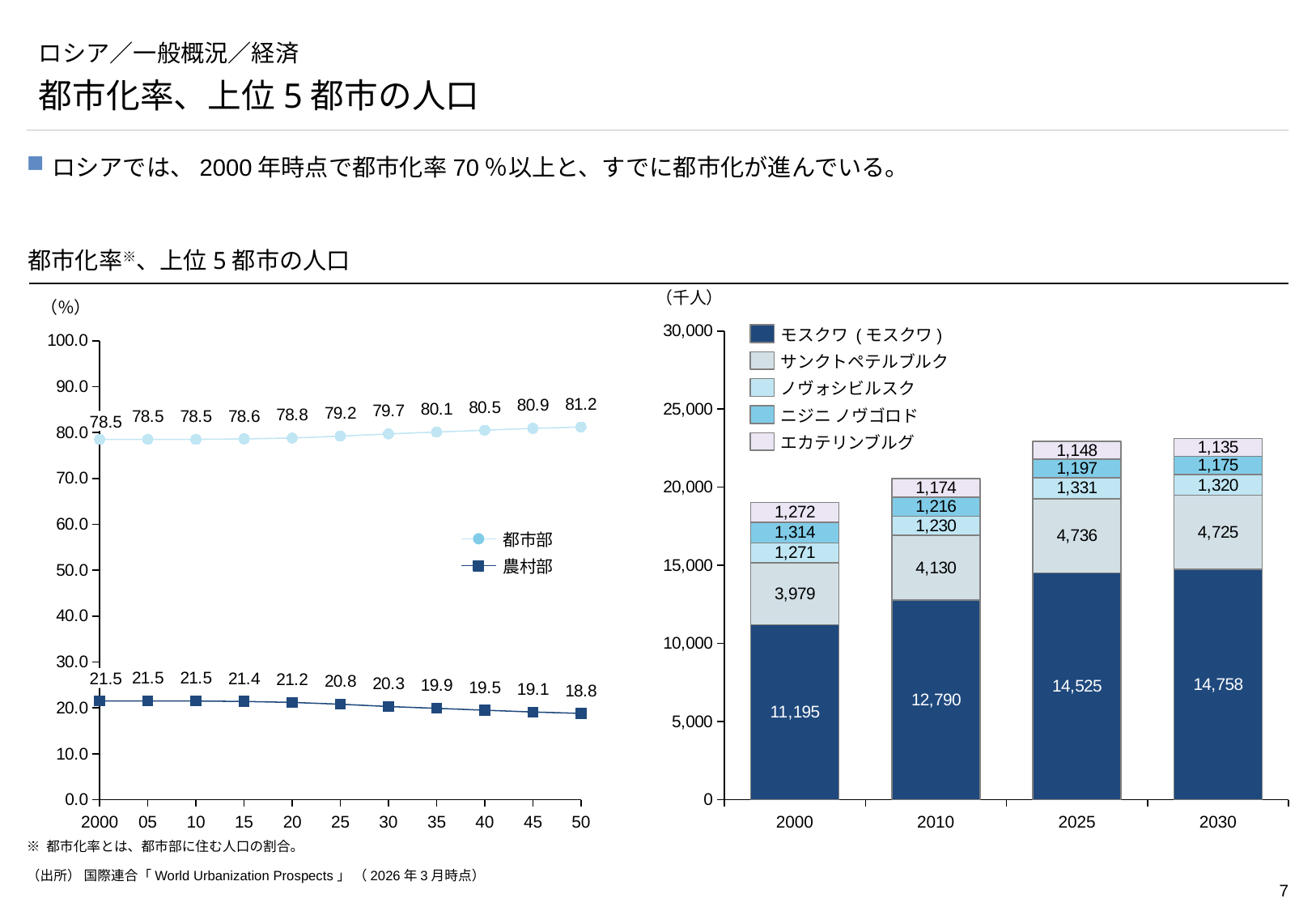
左の都市化率のグラフで、2050年の都市部の値はいくつですか。 81.2 左の都市化率のグラフの凡例には系列がいくつありますか。 2 右の上位5都市の人口のグラフで、2010年のサンクトペテルブルクの値はいくつですか。 4,130 左の都市化率のグラフで、2000年の農村部の値はいくつですか。 21.5 右の上位5都市の人口のグラフで、2030年のモスクワの値はいくつですか。 14,758 左の都市化率のグラフで、農村部の値が最も低いのは何年ですか。 50（2050年） 右の上位5都市の人口のグラフで、2025年のノヴォシビルスクとニジニ ノヴゴロドではどちらが大きいですか。 ノヴォシビルスク 右の上位5都市の人口のグラフで、2030年の棒の合計は20,000より大きいですか、小さいですか。 大きい 右の上位5都市の人口のグラフはどの種類のグラフですか。 積み上げ棒グラフ 右の上位5都市の人口のグラフで、2000年の5都市の合計はいくつですか。 19,031 左の都市化率のグラフで、2050年の都市部と農村部の差はいくつですか。 62.4 左の都市化率のグラフで、都市部の値は2000年から2050年にかけて上昇していますか、下降していますか。 上昇